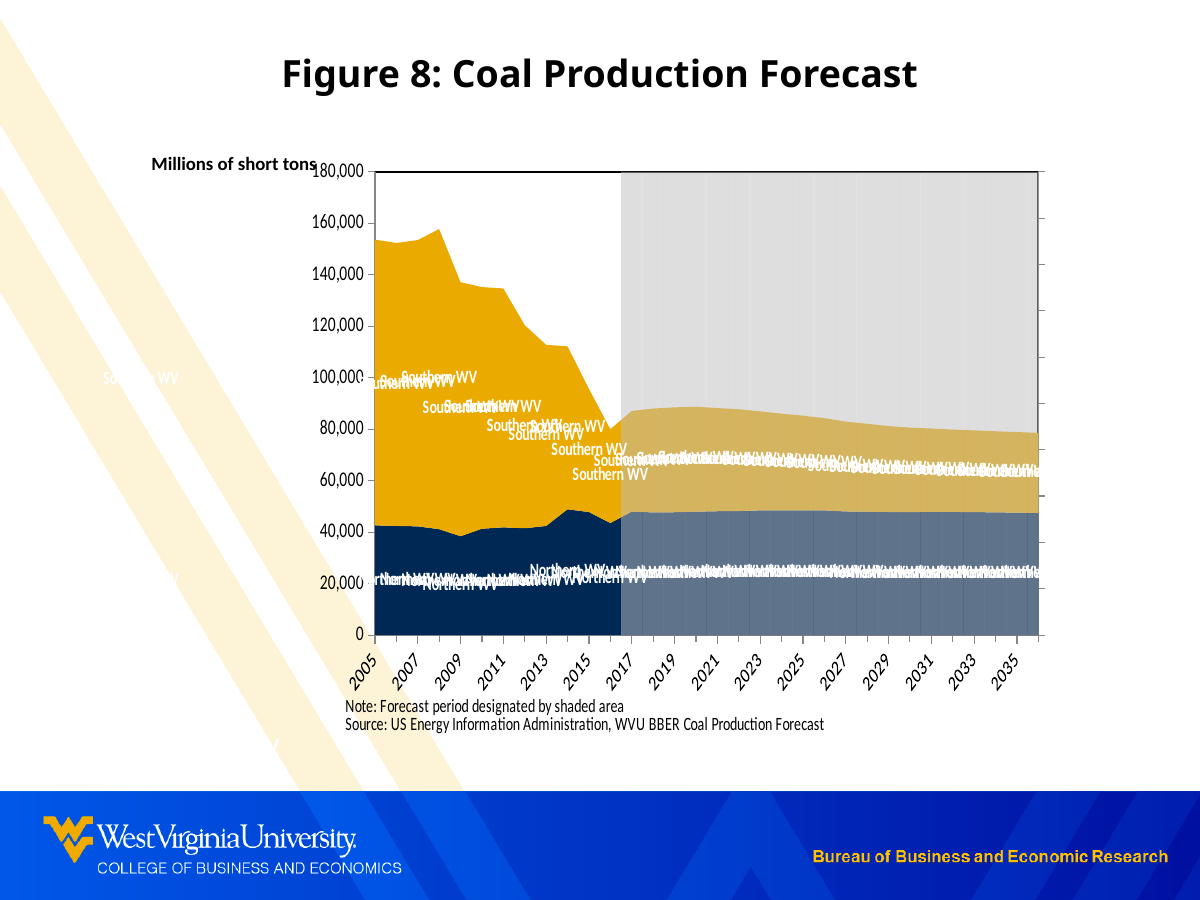
In 2035, which series is larger, Southern WV or Northern WV? Northern WV Which series is plotted at the bottom of the stack, Northern WV or Southern WV? Northern WV How many series are plotted in the chart? 2 Is the total coal production in 2017 greater or less than 100,000? less Is the value for Northern WV in 2017 greater or less than 40,000? greater Does total coal production rise or fall between 2008 and 2016? fall Is the total coal production in 2005 greater or less than 140,000? greater What is the title of the chart? Figure 8: Coal Production Forecast In 2005, which series is larger, Southern WV or Northern WV? Southern WV What kind of chart is shown on the slide? Stacked area chart What unit is the y axis measured in? Millions of short tons